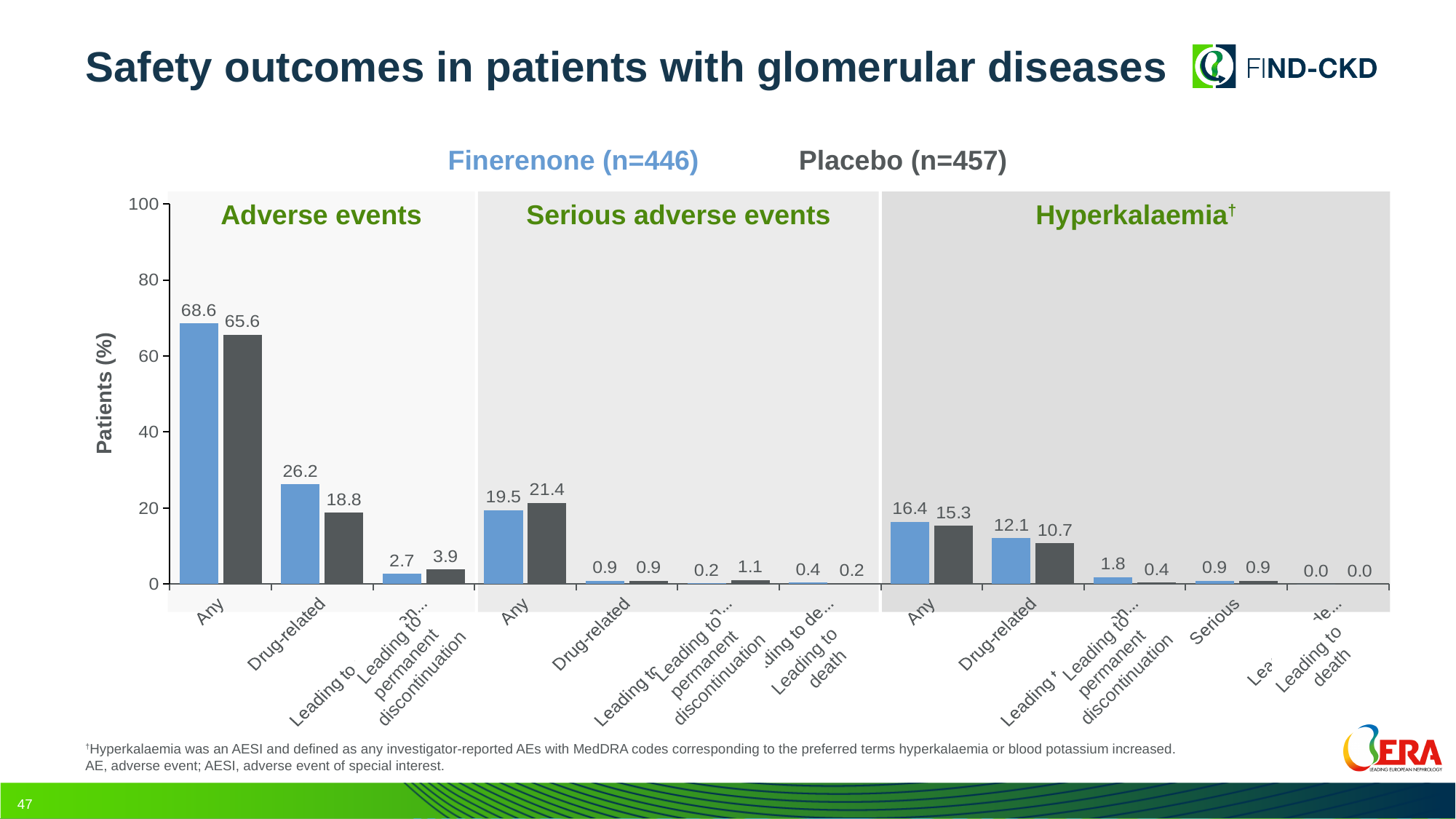
What percentage of finerenone patients had any hyperkalaemia event? 16.4 Which group had the higher rate of any serious adverse event, finerenone or placebo? Placebo Which group had the higher rate of hyperkalaemia leading to permanent discontinuation, finerenone or placebo? Finerenone Is the value for any adverse event in the placebo group greater or less than 60? greater What is the difference between finerenone and placebo for drug-related adverse events? 7.4 What percentage of placebo patients had a drug-related adverse event? 18.8 Which category has the highest value in the chart? Any adverse event (finerenone) What percentage of finerenone patients had any adverse event? 68.6 What type of chart is shown on the slide? Bar chart What is the value for hyperkalaemia leading to death in the placebo group? 0.0 How many treatment groups are shown in the chart? 2 What percentage of placebo patients had any serious adverse event? 21.4